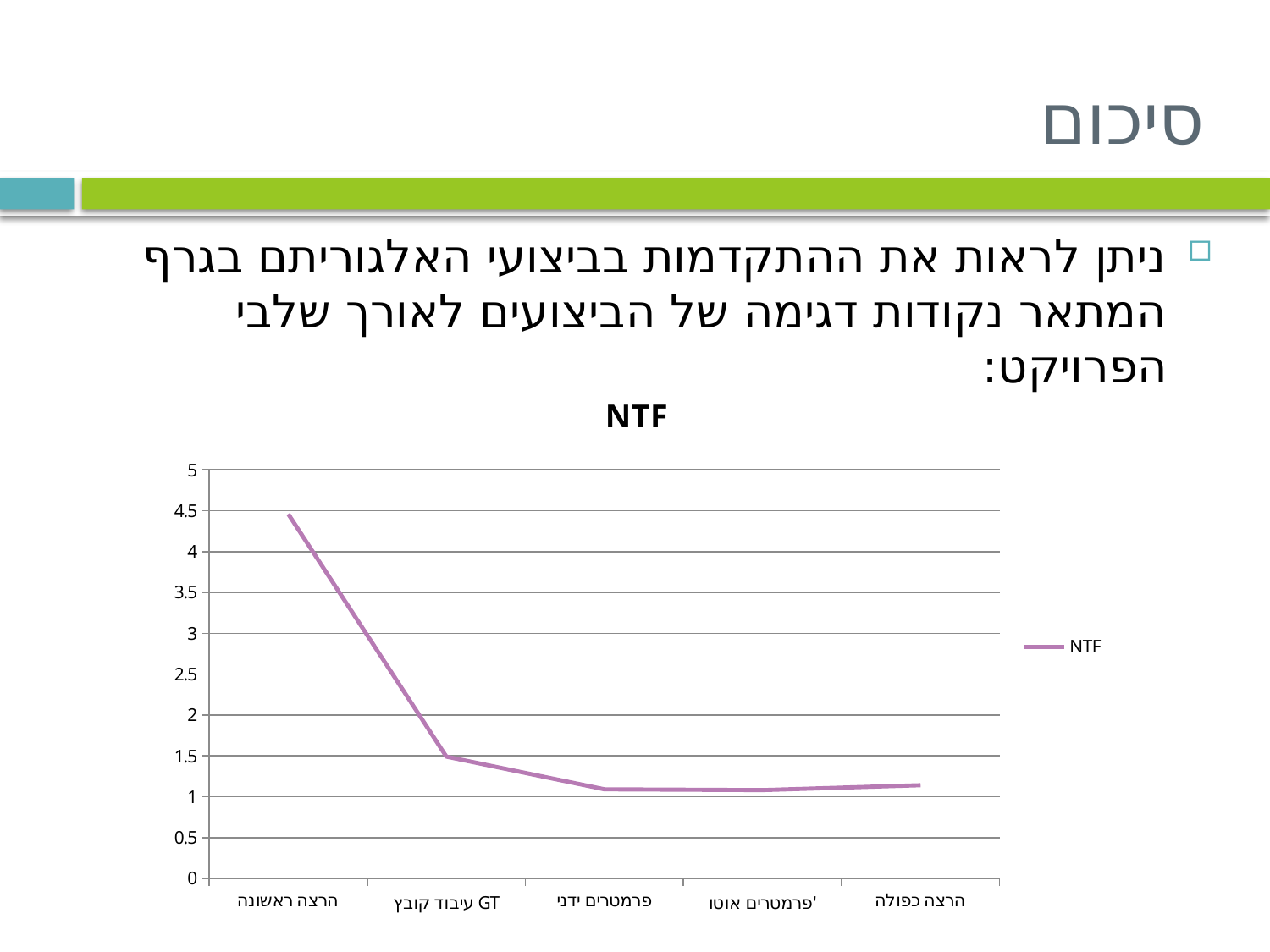
Which category has the highest NTF value? הרצה ראשונה Is the NTF value for עיבוד קובץ GT greater or less than 2? less How many categories are shown on the x axis of the chart? 5 Is the NTF value for הרצה כפולה greater or less than 1.5? less How many series does the legend list? 1 What colour is the NTF line in the chart? purple What kind of chart is shown on the slide? line chart Is the NTF value for פרמטרים ידני greater or less than 1? greater Which has a larger NTF value, הרצה ראשונה or עיבוד קובץ GT? הרצה ראשונה Do the NTF values rise or fall from הרצה ראשונה to פרמטרים ידני? fall What is the title of the chart? NTF